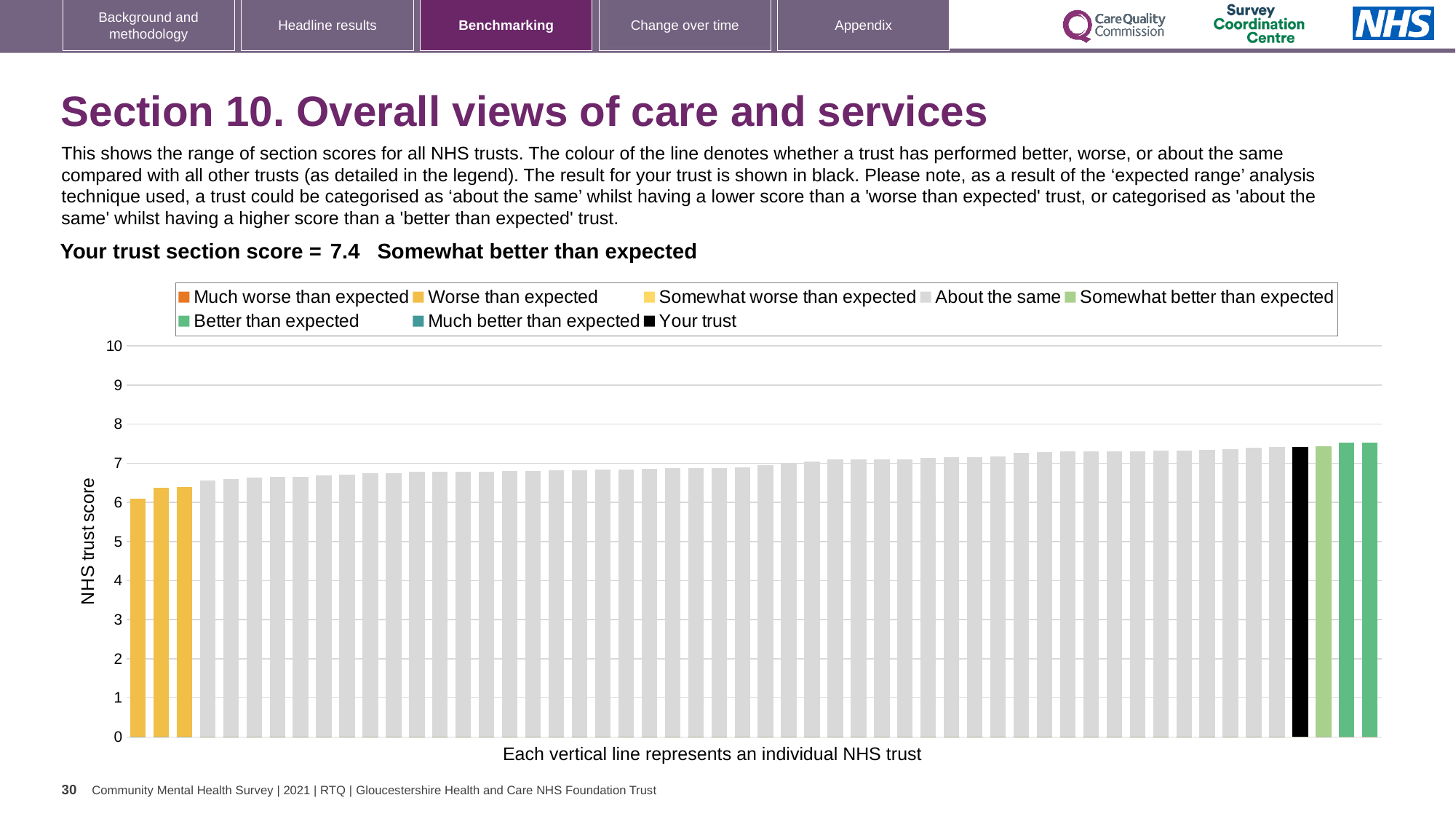
Is the black bar for your trust higher or lower than the leftmost bar in the chart? higher What is the section score for your trust shown on the slide? 7.4 What is the label on the vertical axis of the chart? NHS trust score Do the bar values rise or fall from left to right along the x axis? rise What kind of chart is shown on the slide? bar chart Is the value of the tallest bar in the chart greater or less than 8? less How many entries does the chart legend list? 8 Is the value for your trust (the black bar) greater or less than 7? greater Is the value of the lowest bar in the chart greater or less than 7? less Which category does the slide say your trust's section score falls into? Somewhat better than expected Is the black bar for your trust higher or lower than the tallest bar in the chart? lower How many bars are coloured as 'Worse than expected' (yellow) in the chart? 3